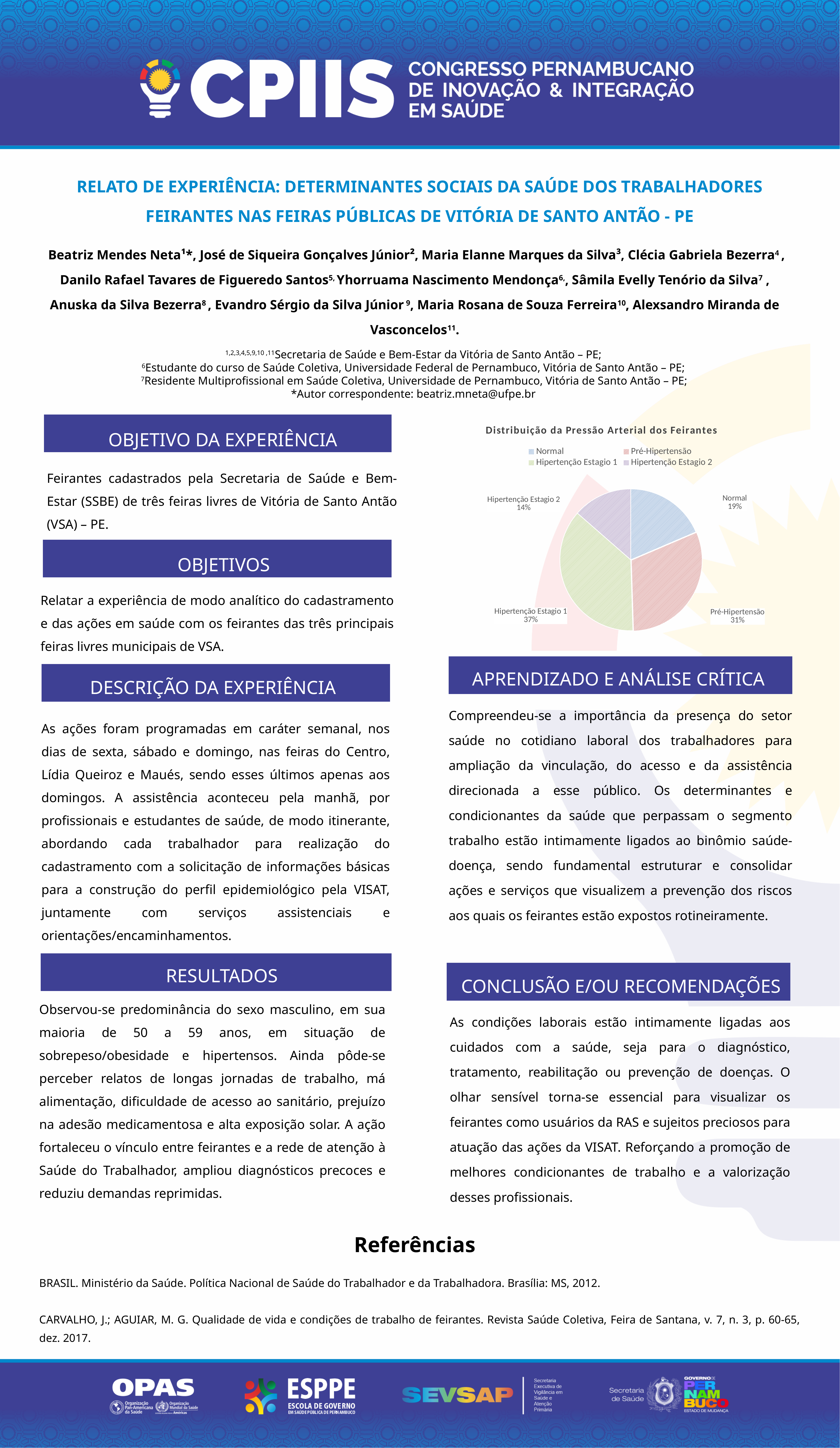
Which is larger in the pie chart: Pré-Hipertensão or Normal? Pré-Hipertensão What percentage is shown for Hipertenção Estagio 2? 14% What percentage is shown for Hipertenção Estagio 1? 37% How many entries does the chart legend list? 4 How many categories does the pie chart show? 4 Which category has the smallest slice in the pie chart? Hipertenção Estagio 2 What is the title of the chart on the slide? Distribuição da Pressão Arterial dos Feirantes What percentage of the feirantes have Normal blood pressure according to the pie chart? 19% What type of chart is shown on the slide? Pie chart What share of the pie chart is labelled Pré-Hipertensão? 31% Which category has the largest slice in the pie chart? Hipertenção Estagio 1 What is the difference in percentage points between Hipertenção Estagio 1 and Normal? 18